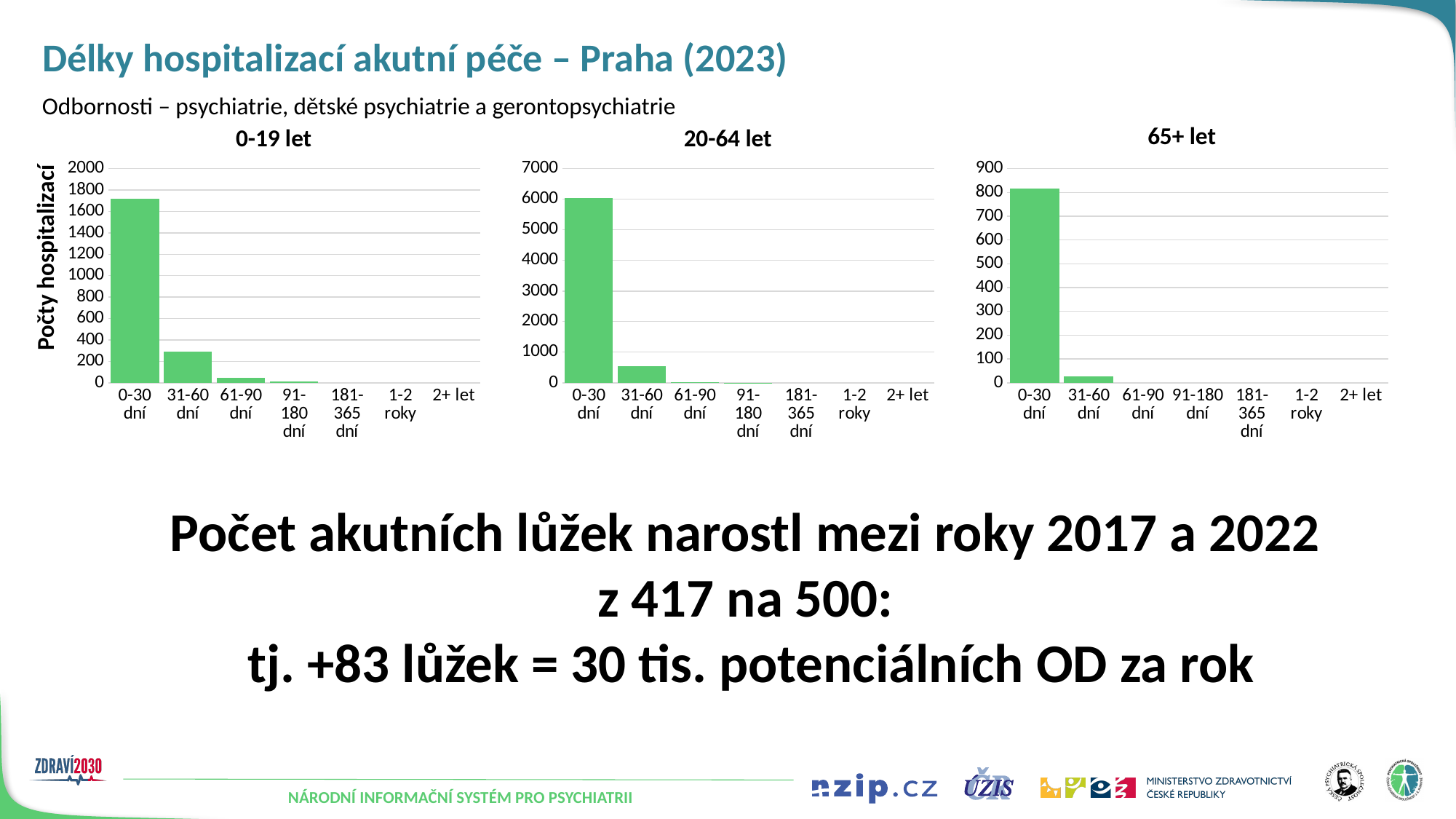
In the chart titled "0-19 let", which category has the highest value? 0-30 dní In the chart titled "0-19 let", is the value for 31-60 dní greater or less than 400? less How many categories are shown on the x axis of the chart titled "65+ let"? 7 In the chart titled "0-19 let", is the value for 0-30 dní greater or less than 1600? greater In the chart titled "20-64 let", which category has the highest value? 0-30 dní In the chart titled "0-19 let", do the values rise or fall from left to right along the x axis? fall In the chart titled "0-19 let", which is larger, the value for 31-60 dní or the value for 61-90 dní? 31-60 dní In the chart titled "20-64 let", is the value for 31-60 dní greater or less than 1000? less What kind of chart is the chart titled "20-64 let"? bar chart